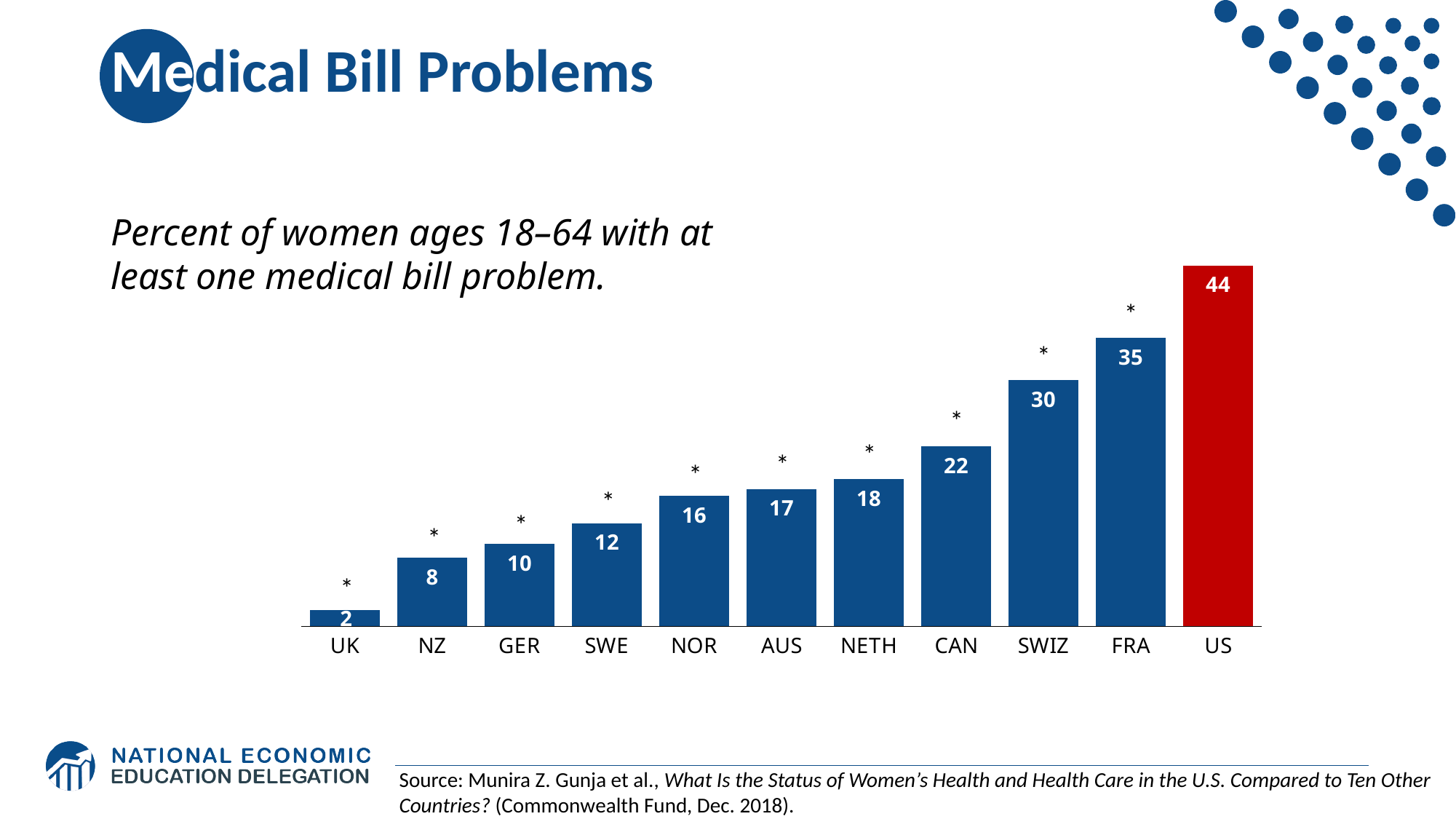
How many countries are shown on the chart? 11 What is the difference between the values for the US and FRA? 9 What kind of chart is this? Bar chart What is the value for SWE? 12 Which bar is coloured red rather than blue? US What is the value for CAN? 22 Which has a larger value, NOR or NETH? NETH What is the value for the US? 44 What is the difference between the values for SWIZ and NZ? 22 Which country has the highest value? US Do the values rise or fall from left to right along the x axis? Rise Which country has the lowest value? UK